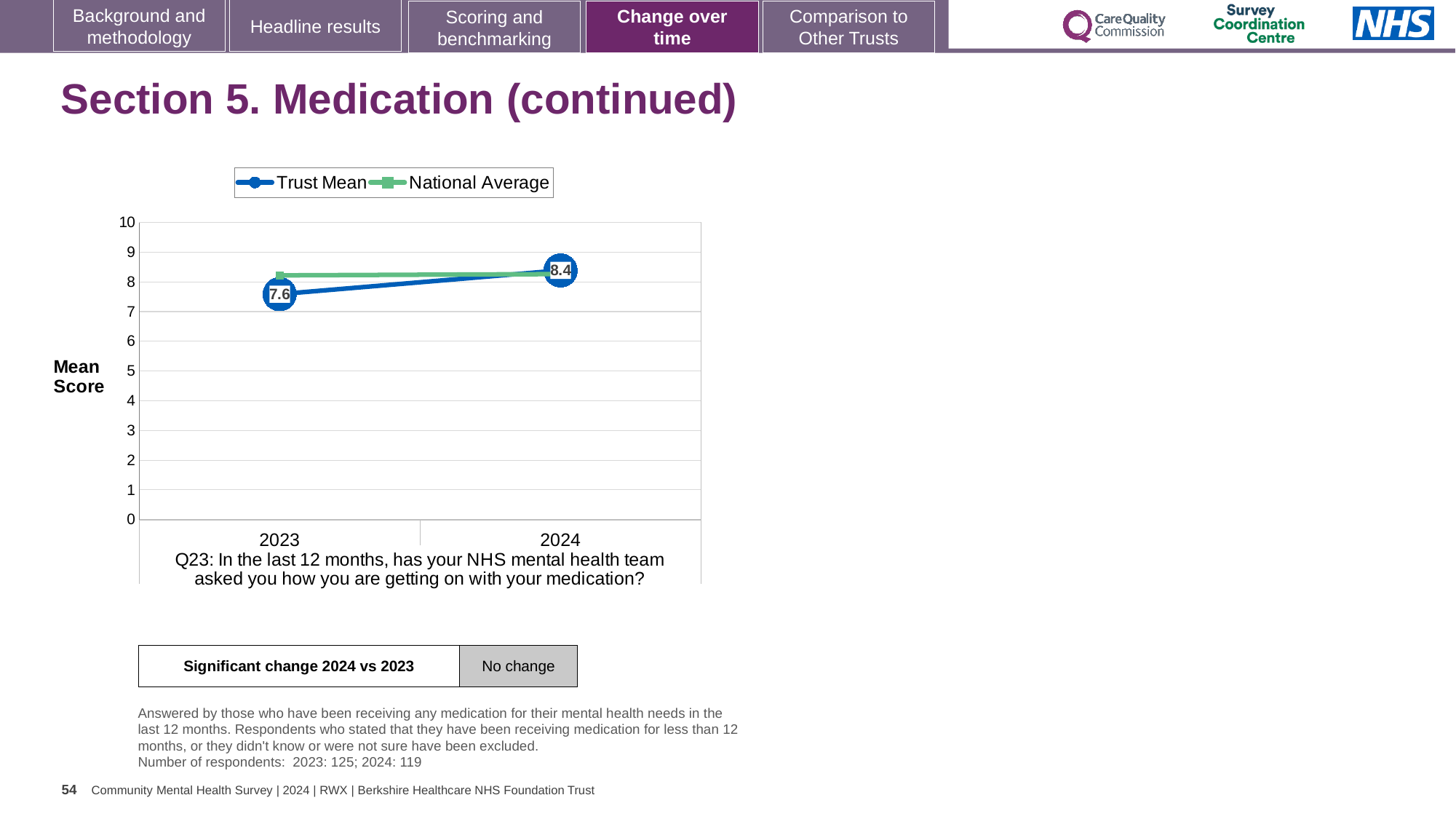
How many years are plotted on the x axis? 2 In 2023, which is larger: the Trust Mean or the National Average? National Average Does the Trust Mean rise or fall from 2023 to 2024? rise What is the Trust Mean value for 2024? 8.4 What is the Trust Mean value for 2023? 7.6 What is the label on the y axis of the chart? Mean Score Is the National Average value for 2023 greater or less than 7? greater What are the two series named in the legend? Trust Mean and National Average How many series does the legend list? 2 In which year is the Trust Mean higher? 2024 What kind of chart is shown on the slide? line chart By how much did the Trust Mean change from 2023 to 2024? 0.8